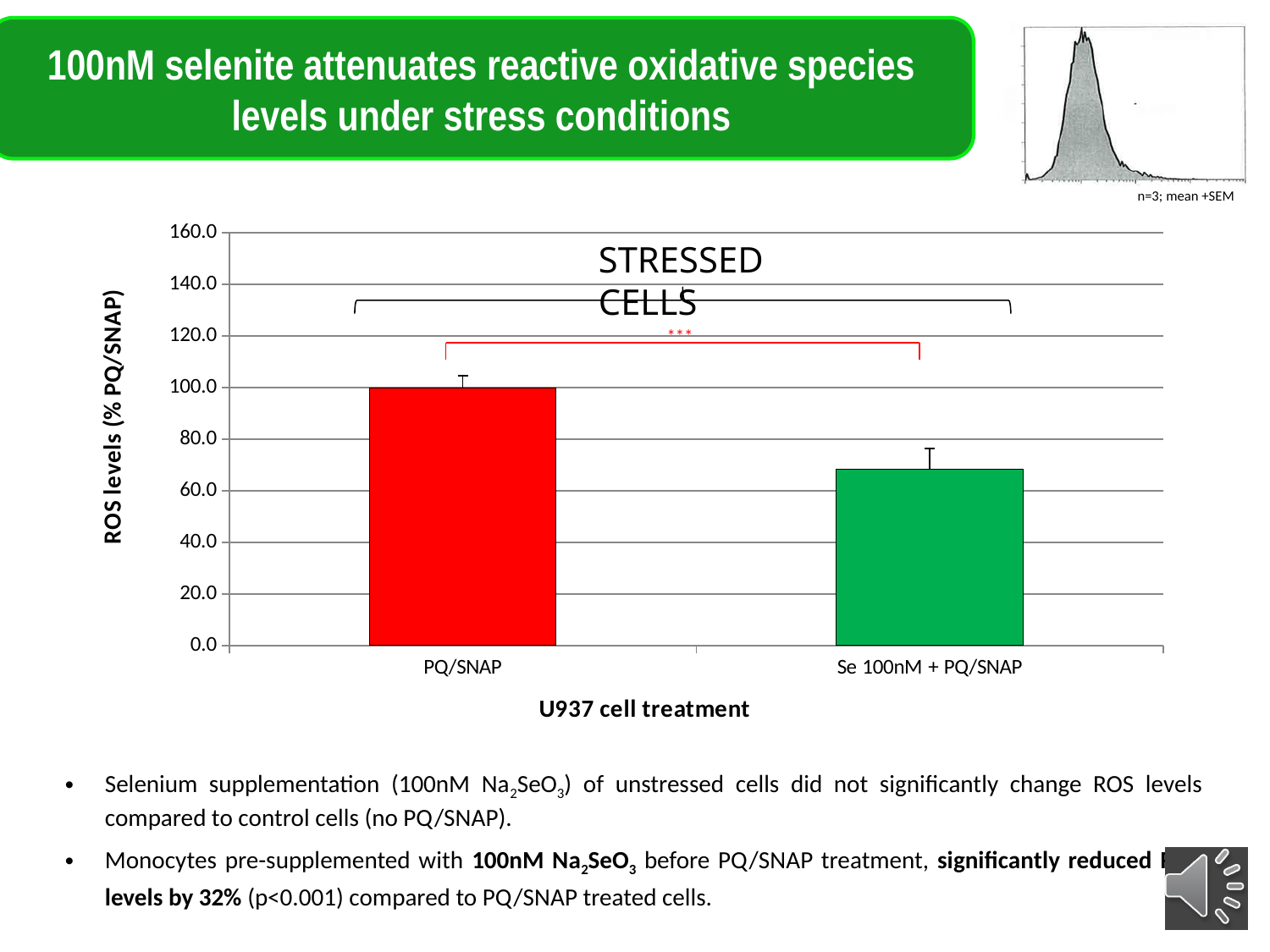
How many bars (categories) are plotted in the chart? 2 Do the bar values rise or fall from left to right along the x axis? fall What is the ROS level value for PQ/SNAP? 100.0 Which category has the highest ROS level in the chart? PQ/SNAP What is the label of the y axis of the chart? ROS levels (% PQ/SNAP) Which category has the lowest ROS level in the chart? Se 100nM + PQ/SNAP What kind of chart is shown on the slide? bar chart Is the ROS level for Se 100nM + PQ/SNAP greater or less than 80.0? less What is the label of the x axis of the chart? U937 cell treatment Which has a larger ROS level: PQ/SNAP or Se 100nM + PQ/SNAP? PQ/SNAP Is the ROS level for Se 100nM + PQ/SNAP greater or less than 60.0? greater